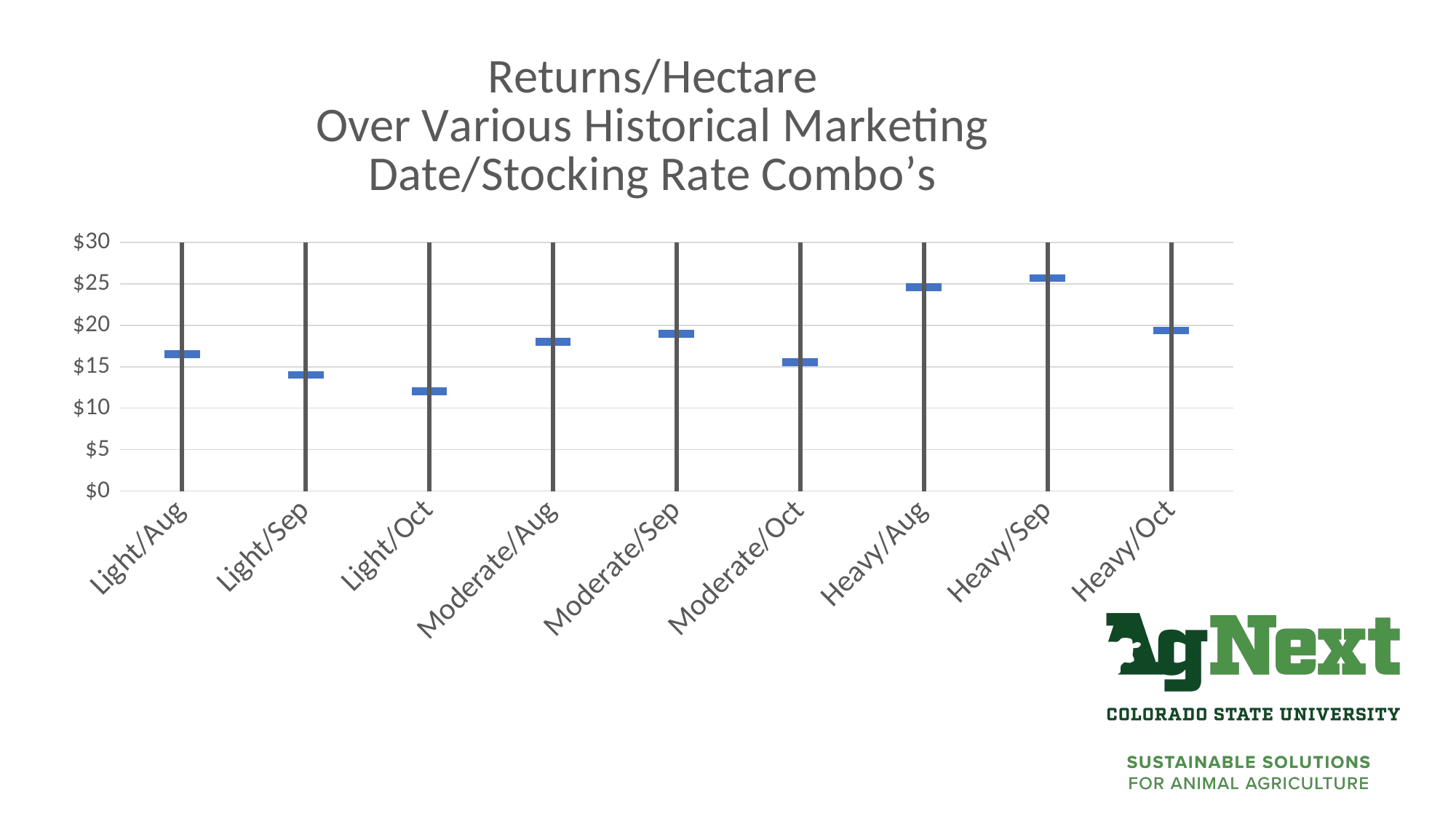
Is the value for Light/Oct greater or less than $15? less Is the value for Heavy/Aug greater or less than $20? greater What is the highest value shown on the vertical axis? $30 Which combination has the lowest returns per hectare? Light/Oct Do the returns rise or fall from Light/Aug to Light/Oct? fall Which has higher returns per hectare, Heavy/Aug or Moderate/Aug? Heavy/Aug Is the value for Light/Sep greater or less than $15? less Which combination has the highest returns per hectare? Heavy/Sep Which has higher returns per hectare, Light/Aug or Light/Sep? Light/Aug How many marketing date/stocking rate combinations are plotted on the chart? 9